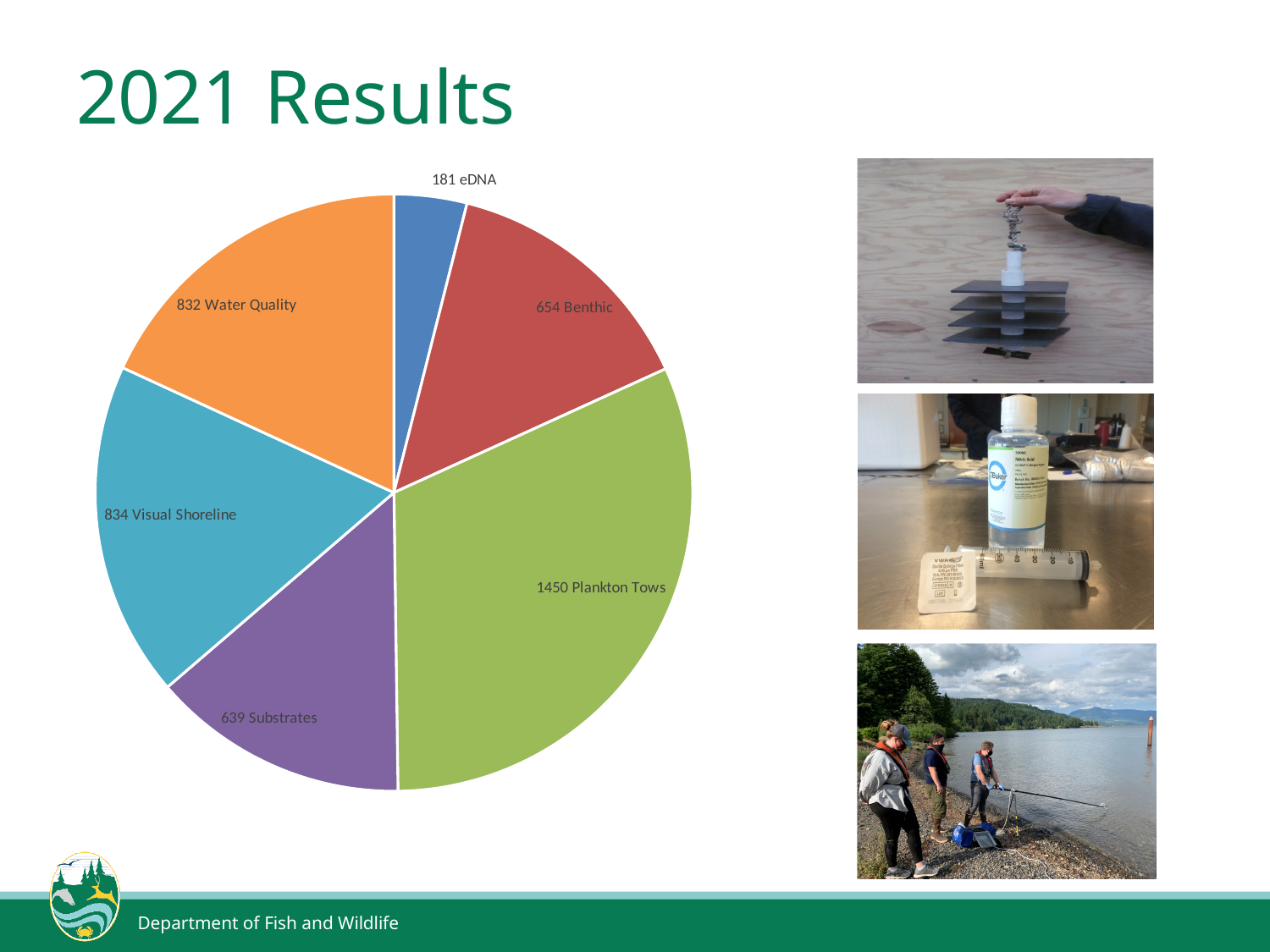
What kind of chart is shown on the slide? Pie chart What is the value shown for Benthic in the pie chart? 654 Which category has the smallest slice in the pie chart? eDNA What is the value shown for Plankton Tows in the pie chart? 1450 What colour is the Plankton Tows slice in the pie chart? Green Which category has the largest slice in the pie chart? Plankton Tows How many categories are shown in the pie chart? 6 What is the total of all the values shown in the pie chart? 4590 Which is larger, the Benthic value or the Substrates value? Benthic What is the value shown for eDNA in the pie chart? 181 What is the difference between the Visual Shoreline value and the Substrates value? 195 What is the difference between the Plankton Tows value and the Benthic value? 796